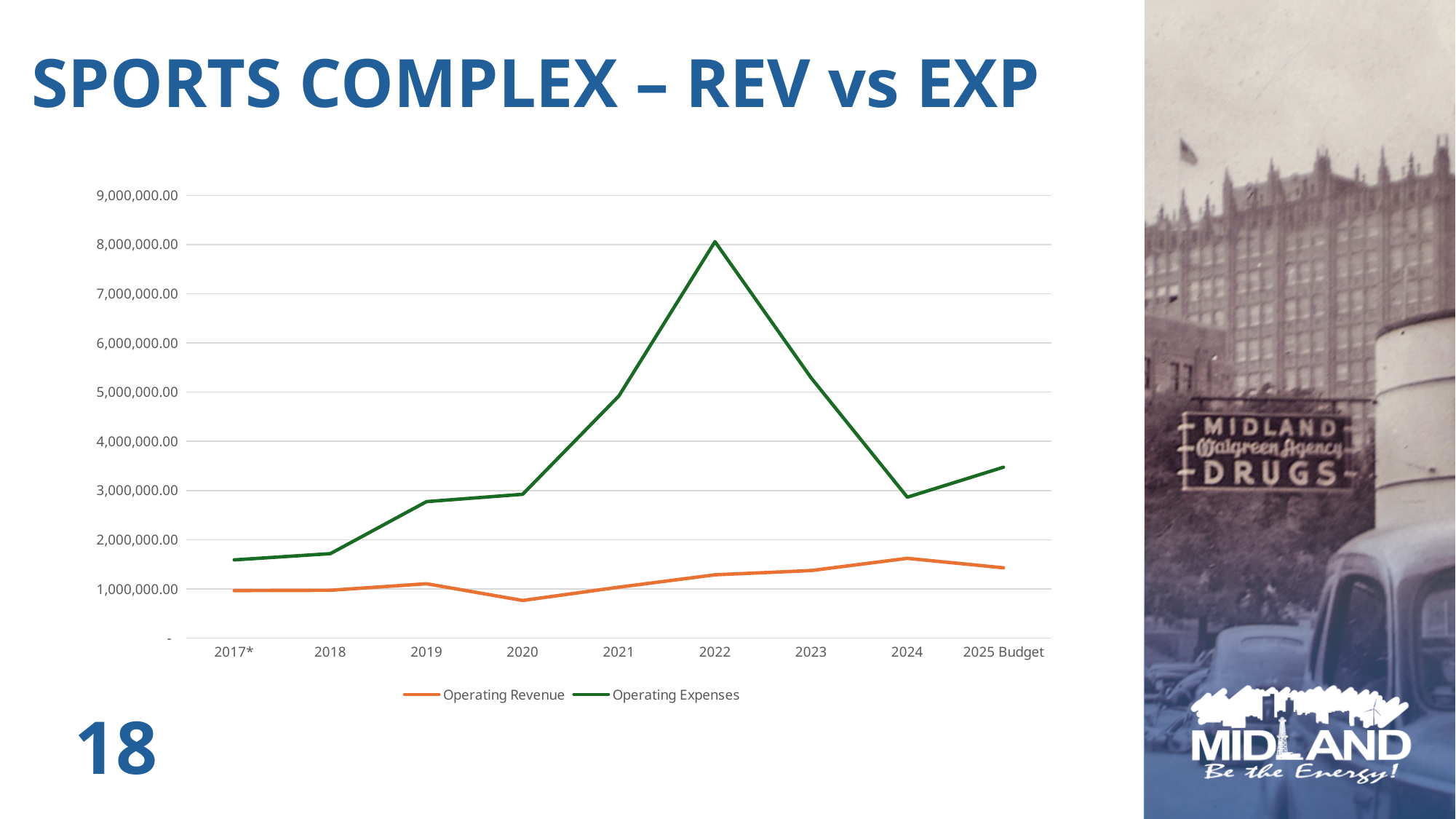
In which year is Operating Revenue at its lowest? 2020 Which colour is used for the Operating Revenue line? orange Do Operating Expenses rise or fall from 2022 to 2024? fall How many series does the legend list? 2 What kind of chart is shown on the slide? line chart Is the value for Operating Expenses in 2017* greater or less than 2,000,000.00? less Is the value for Operating Expenses in 2022 greater or less than 7,000,000.00? greater How many years (categories) are shown on the x axis? 9 Is the value for Operating Expenses in the 2025 Budget greater or less than 3,000,000.00? greater In 2022, which is larger: Operating Revenue or Operating Expenses? Operating Expenses In which year do Operating Expenses reach their highest value? 2022